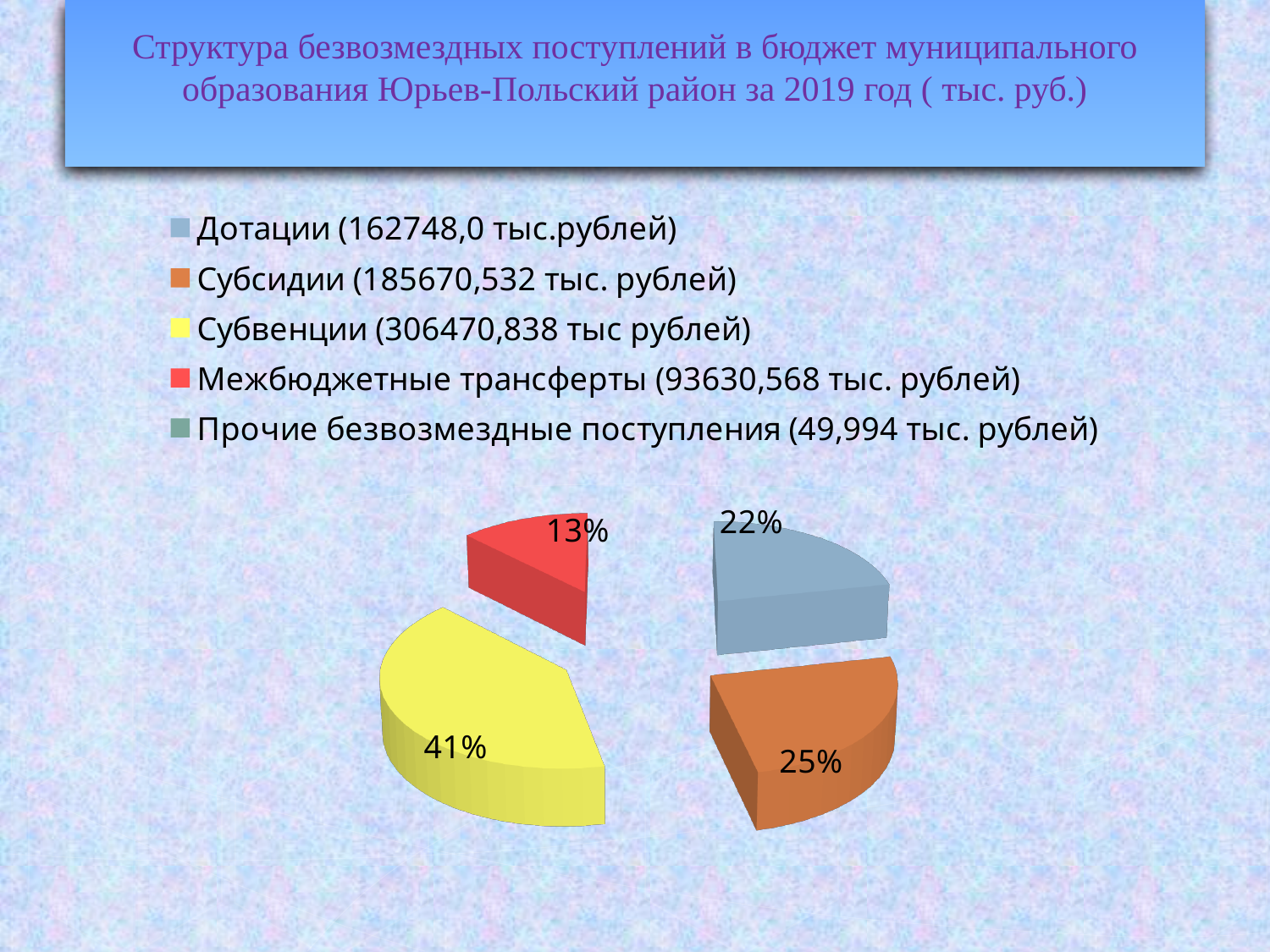
What is the difference in percentage points between the Субвенции share and the Межбюджетные трансферты share? 28% Which is larger, the share for Субсидии or the share for Дотации? Субсидии What percentage share does the Межбюджетные трансферты slice have? 13% What percentage share does the Дотации slice have? 22% Which category has the largest share of the pie? Субвенции What percentage share does the Субсидии slice have? 25% What type of chart is shown on the slide? pie chart How many categories does the legend list? 5 What value in thousand rubles is given for Дотации in the legend? 162748,0 What value in thousand rubles is given for Субвенции in the legend? 306470,838 What value in thousand rubles is given for Прочие безвозмездные поступления in the legend? 49,994